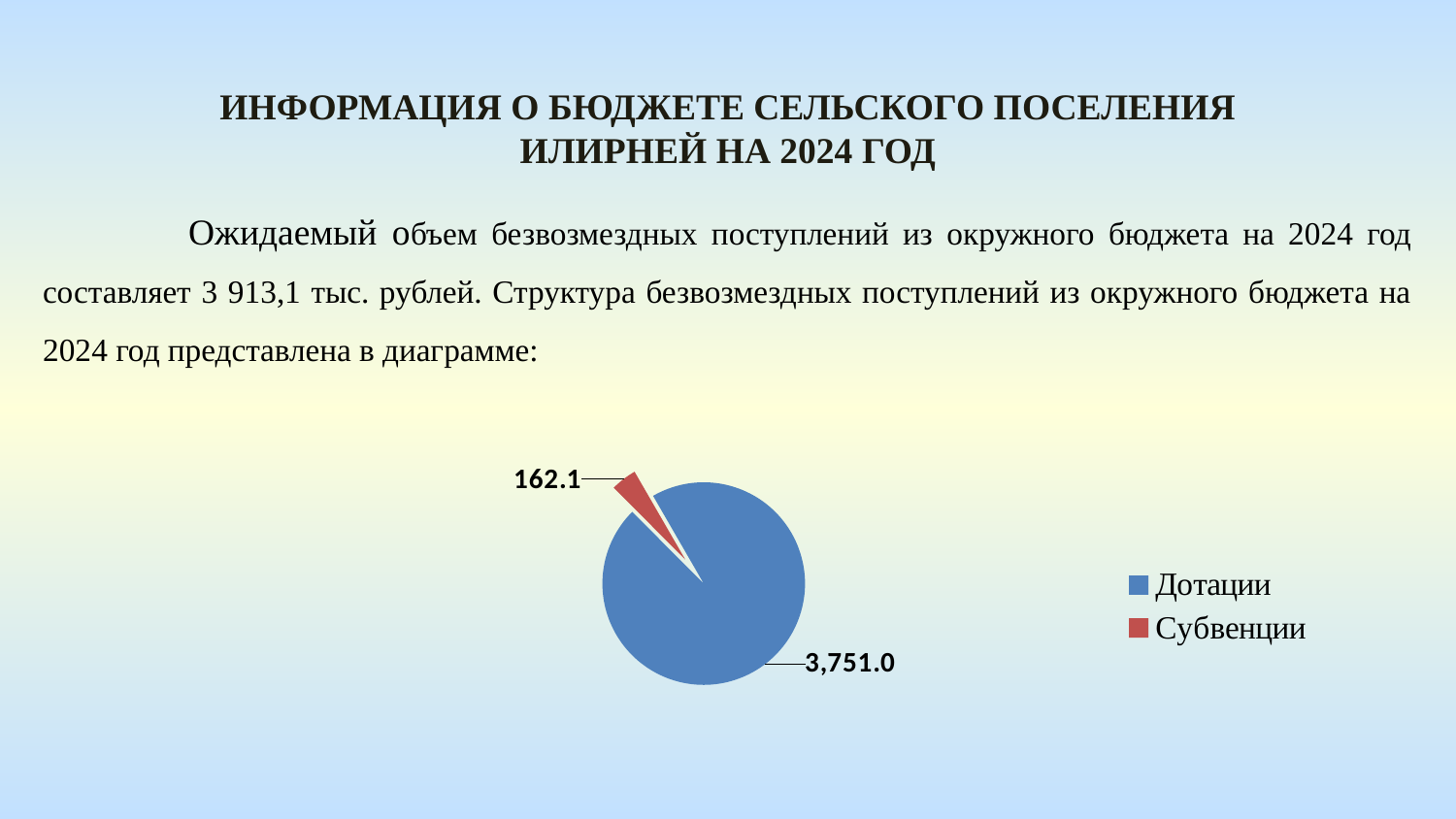
How many entries does the legend of the pie chart list? 2 What colour is the Субвенции slice in the pie chart? Red What is the difference between the Дотации and Субвенции values in the pie chart? 3,588.9 Which is larger in the pie chart, Дотации or Субвенции? Дотации What is the total of the two slices in the pie chart? 3,913.1 What share of the pie does the Субвенции slice represent? 4.1% Which category has the largest slice in the pie chart? Дотации What is the value of the Дотации slice in the pie chart? 3,751.0 How many slices does the pie chart have? 2 Which category has the smallest slice in the pie chart? Субвенции What kind of chart is shown on the slide? Pie chart What is the value of the Субвенции slice in the pie chart? 162.1